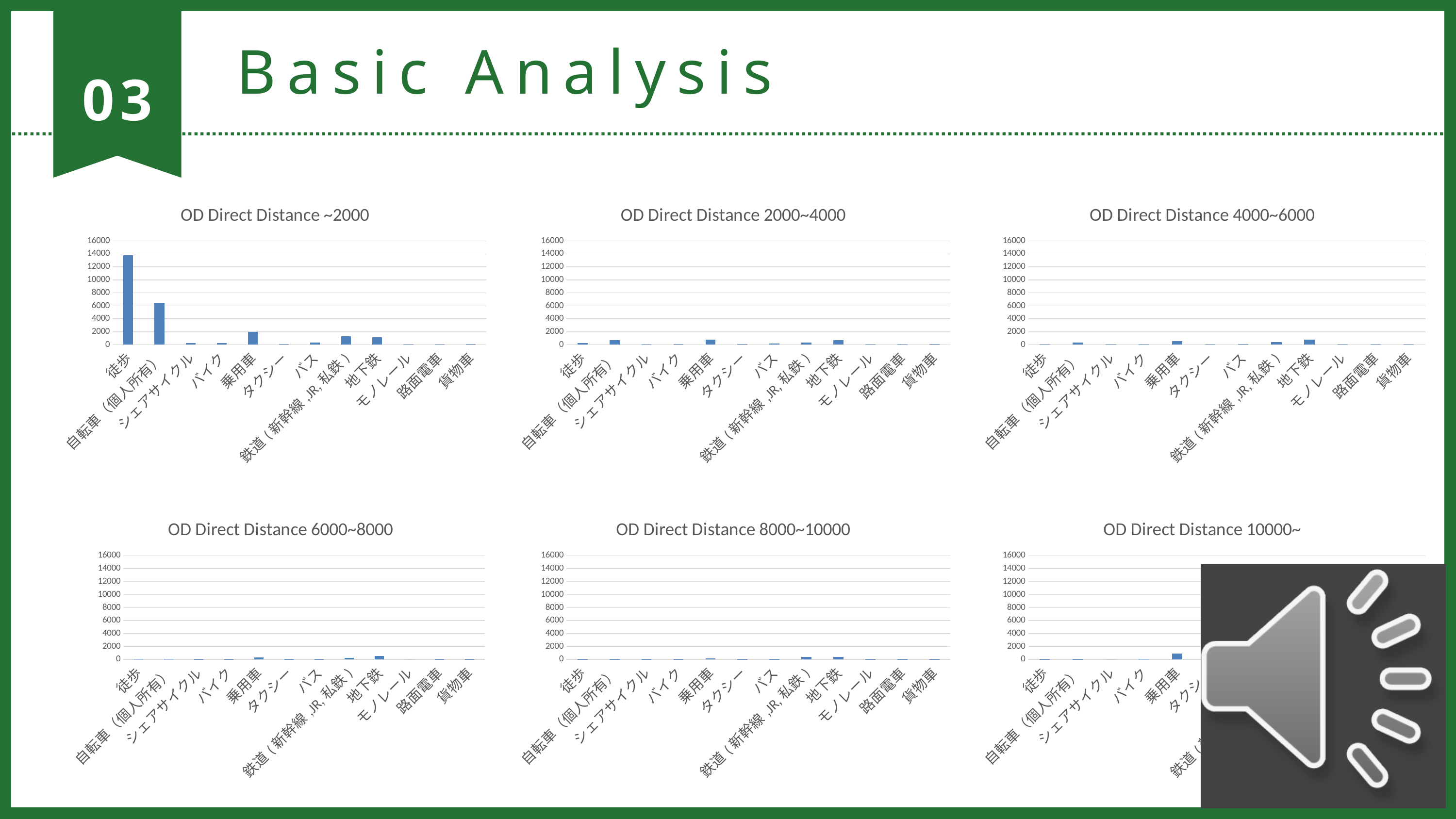
In the "OD Direct Distance 2000~4000" chart, is the value for 徒歩 greater or less than 2000? less How many bar charts are shown on the slide? 6 How many categories are shown on the x axis of the "OD Direct Distance ~2000" chart? 12 In the "OD Direct Distance ~2000" chart, is the value for 徒歩 greater or less than 12000? greater In the "OD Direct Distance ~2000" chart, which is larger, the value for 徒歩 or the value for 自転車（個人所有）? 徒歩 What is the highest value shown on the y axis of the "OD Direct Distance 4000~6000" chart? 16000 What kind of chart is "OD Direct Distance ~2000"? bar chart In the "OD Direct Distance ~2000" chart, which category has the highest value? 徒歩 In the "OD Direct Distance 6000~8000" chart, which category has the highest value? 地下鉄 In the "OD Direct Distance ~2000" chart, which is larger, the value for 乗用車 or the value for タクシー? 乗用車 In the "OD Direct Distance ~2000" chart, is the value for 自転車（個人所有） greater or less than 8000? less